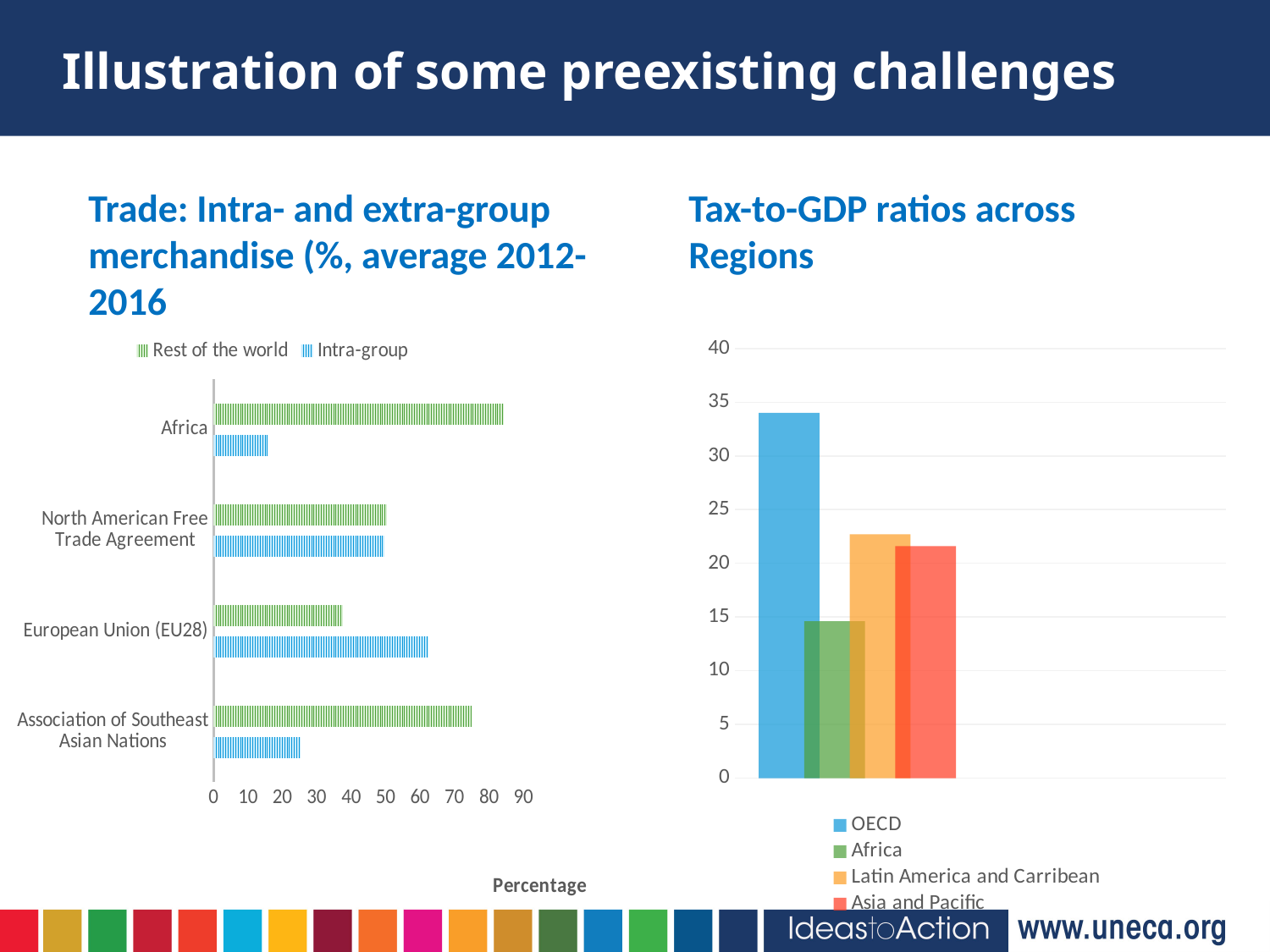
How many categories are shown on the 'Trade: Intra- and extra-group merchandise' chart? 4 In the 'Trade: Intra- and extra-group merchandise' chart, is the 'Rest of the world' value for Africa greater or less than 80? greater In the 'Trade: Intra- and extra-group merchandise' chart, which is larger for European Union (EU28): 'Rest of the world' or 'Intra-group'? Intra-group In the 'Trade: Intra- and extra-group merchandise' chart, which category has the lowest 'Intra-group' value? Africa In the 'Tax-to-GDP ratios across Regions' chart, is the value for Africa greater or less than 15? less What is the x-axis title of the 'Trade: Intra- and extra-group merchandise' chart? Percentage In the 'Trade: Intra- and extra-group merchandise' chart, is the 'Intra-group' value for European Union (EU28) greater or less than 50? greater What kind of chart is the 'Trade: Intra- and extra-group merchandise' chart on the left? bar chart How many series does the legend of the 'Trade: Intra- and extra-group merchandise' chart list? 2 In the 'Tax-to-GDP ratios across Regions' chart, which region has the highest tax-to-GDP ratio? OECD In the 'Trade: Intra- and extra-group merchandise' chart, which category has the highest 'Rest of the world' value? Africa How many series does the legend of the 'Tax-to-GDP ratios across Regions' chart list? 4